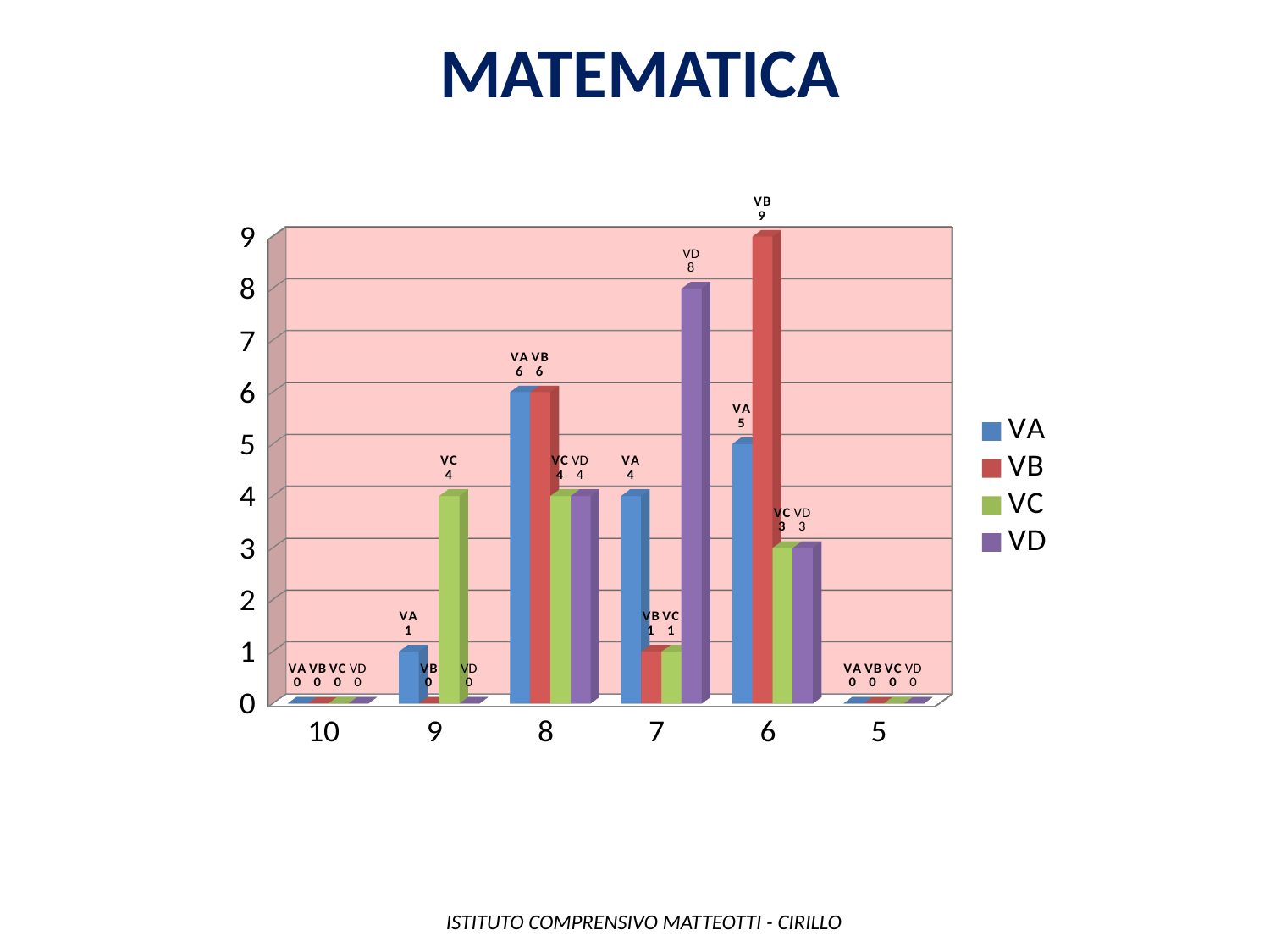
How many categories are shown on the x axis? 6 What is the difference between the VB value and the VC value in category 6? 6 Which series has the lowest value in category 7? VB and VC What is the value for VB in category 6? 9 Which is larger in category 7: the value for VA or the value for VD? VD What kind of chart is shown on the slide? bar chart How many series does the legend list? 4 What is the value for VA in category 8? 6 What is the value for VD in category 7? 8 What is the value for VC in category 9? 4 Which series has the highest value in category 6? VB What is the title of the chart? MATEMATICA